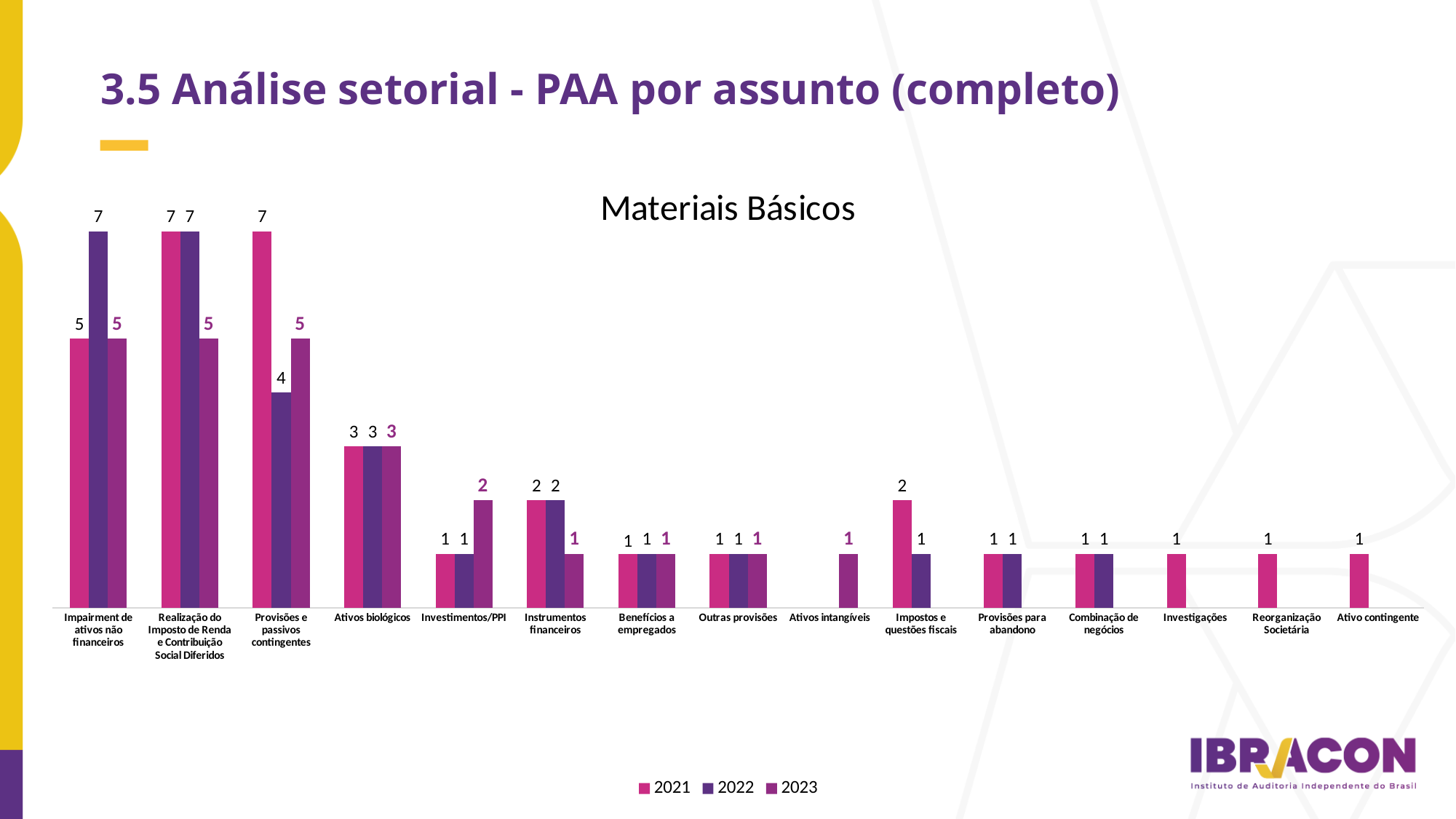
What is the 2021 value for Impostos e questões fiscais? 2 What is the difference between the 2021 and 2022 values for Provisões e passivos contingentes? 3 Which is larger for Instrumentos financeiros: the 2021 value or the 2023 value? 2021 Which category has the highest 2021 value? Realização do Imposto de Renda e Contribuição Social Diferidos and Provisões e passivos contingentes (both 7) Which years are listed in the legend? 2021, 2022, 2023 What is the 2022 value for Impairment de ativos não financeiros? 7 What kind of chart is shown? Bar chart What is the title of the chart? Materiais Básicos How many categories are shown on the x axis? 15 What is the 2023 value for Provisões e passivos contingentes? 5 How many series does the legend list? 3 What is the 2023 value for Investimentos/PPI? 2